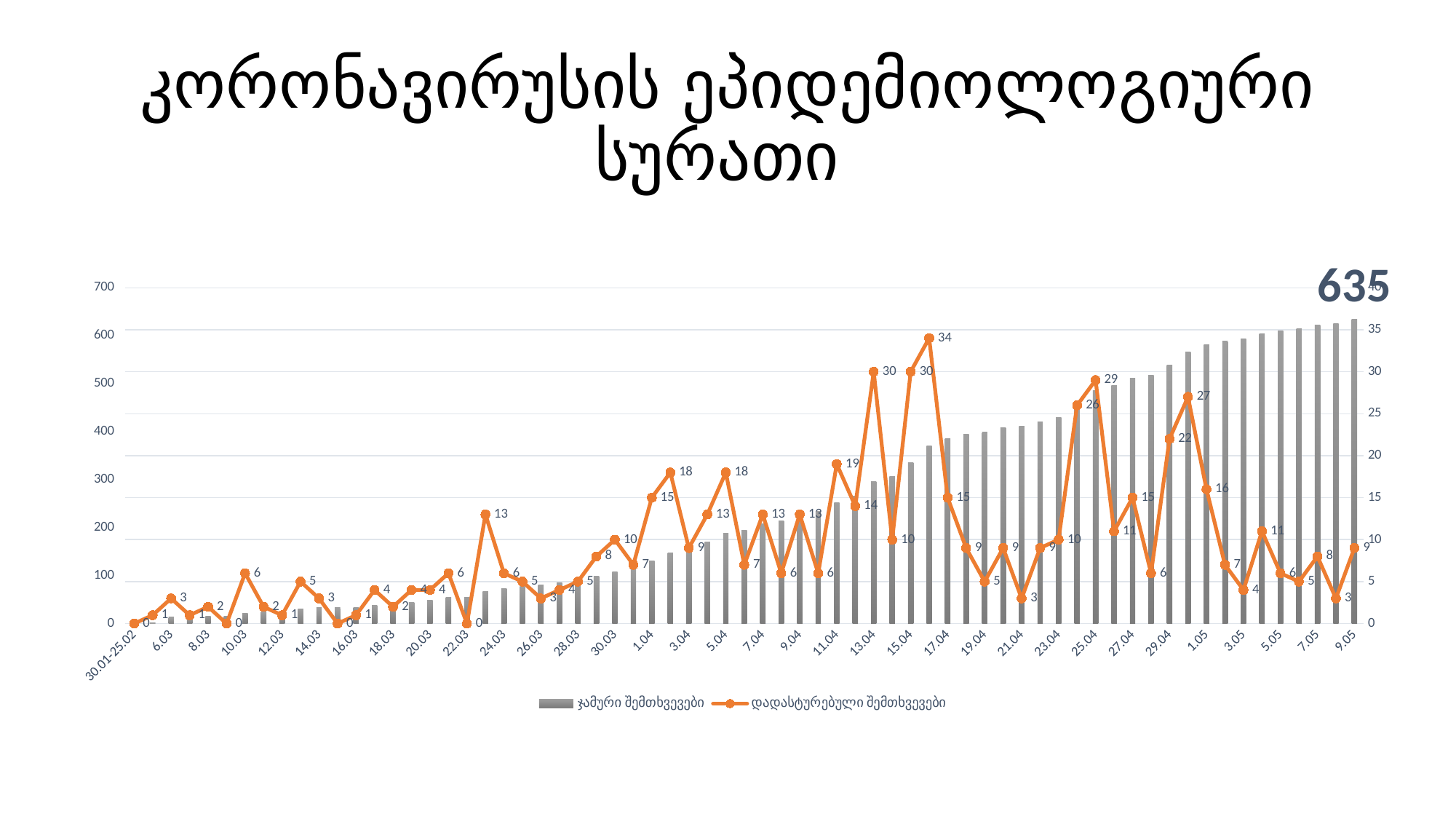
Is the cumulative cases bar for 1.04 greater or less than 200? less Which date has the larger confirmed cases line value, 5.04 or 3.04? 5.04 What is the difference between the confirmed cases line values on 13.04 and 11.04? 11 Is the cumulative cases bar for 25.04 greater or less than 400? greater What type of chart is shown on the slide? A combined bar and line chart How many series does the legend list? 2 What is the highest value reached by the confirmed cases line? 34 What is the value of the confirmed cases line on 1.04? 15 What is the value of the confirmed cases line (დადასტურებული შემთხვევები) on 13.04? 30 What is the value of the confirmed cases line on 9.05? 9 What is the cumulative total (ჯამური შემთხვევები) shown at the end of the chart on 9.05? 635 Do the cumulative cases bars rise or fall from left to right along the x axis? Rise